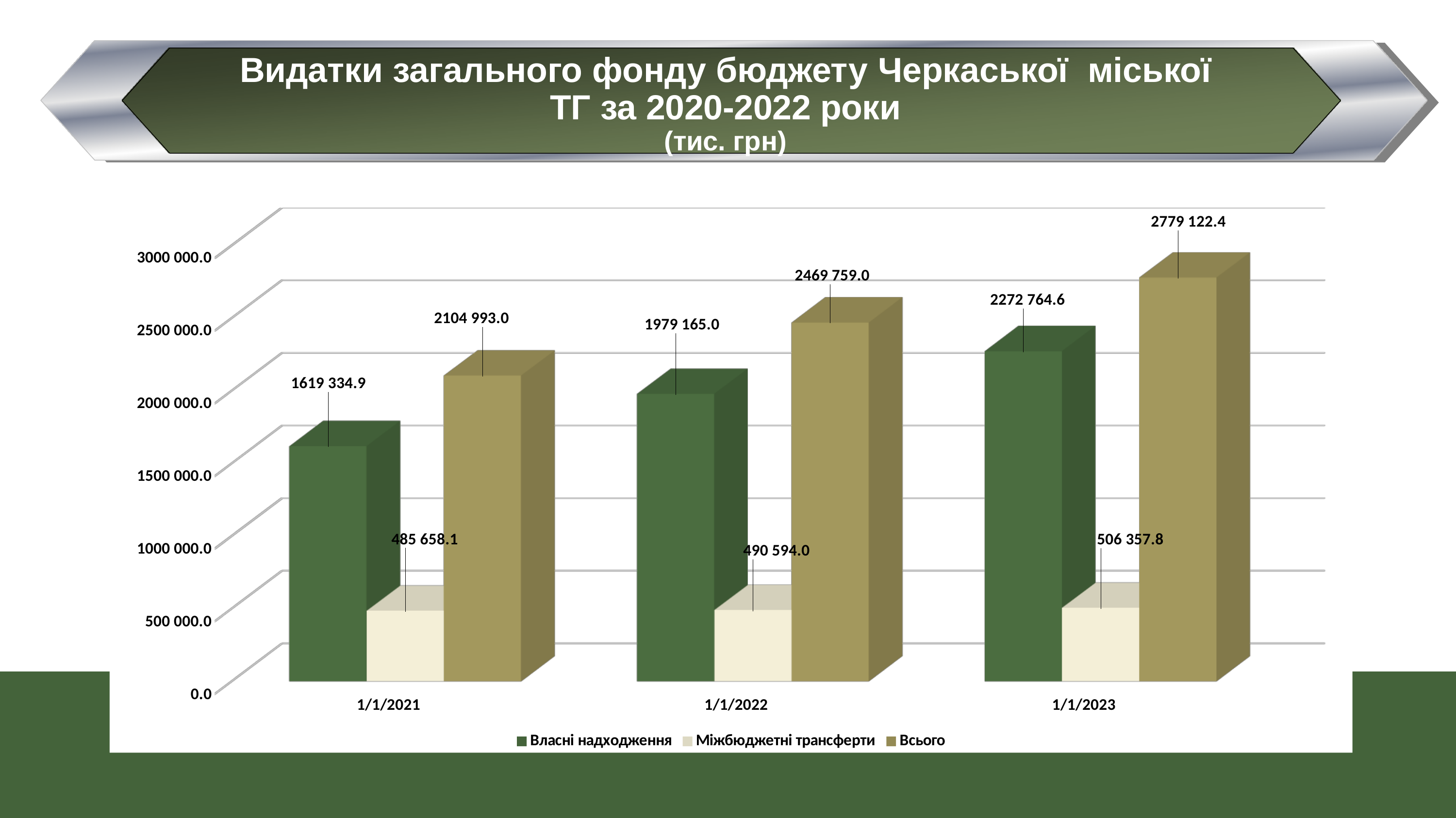
How many categories are shown on the x axis? 3 Which category has the lowest value for Міжбюджетні трансферти? 1/1/2021 How many series does the legend list? 3 What is the difference between Власні надходження for 1/1/2023 and for 1/1/2022? 293 599.6 What is the value of Всього for 1/1/2023? 2779 122.4 What is the difference between Всього for 1/1/2023 and Всього for 1/1/2022? 309 363.4 Do the values for Всього rise or fall from 1/1/2021 to 1/1/2023? rise Which is larger: Власні надходження for 1/1/2022 or Всього for 1/1/2021? Всього for 1/1/2021 What is the value of Власні надходження for 1/1/2021? 1619 334.9 What kind of chart is shown on the slide? bar chart Which category has the highest value for Всього? 1/1/2023 What is the value of Міжбюджетні трансферти for 1/1/2022? 490 594.0